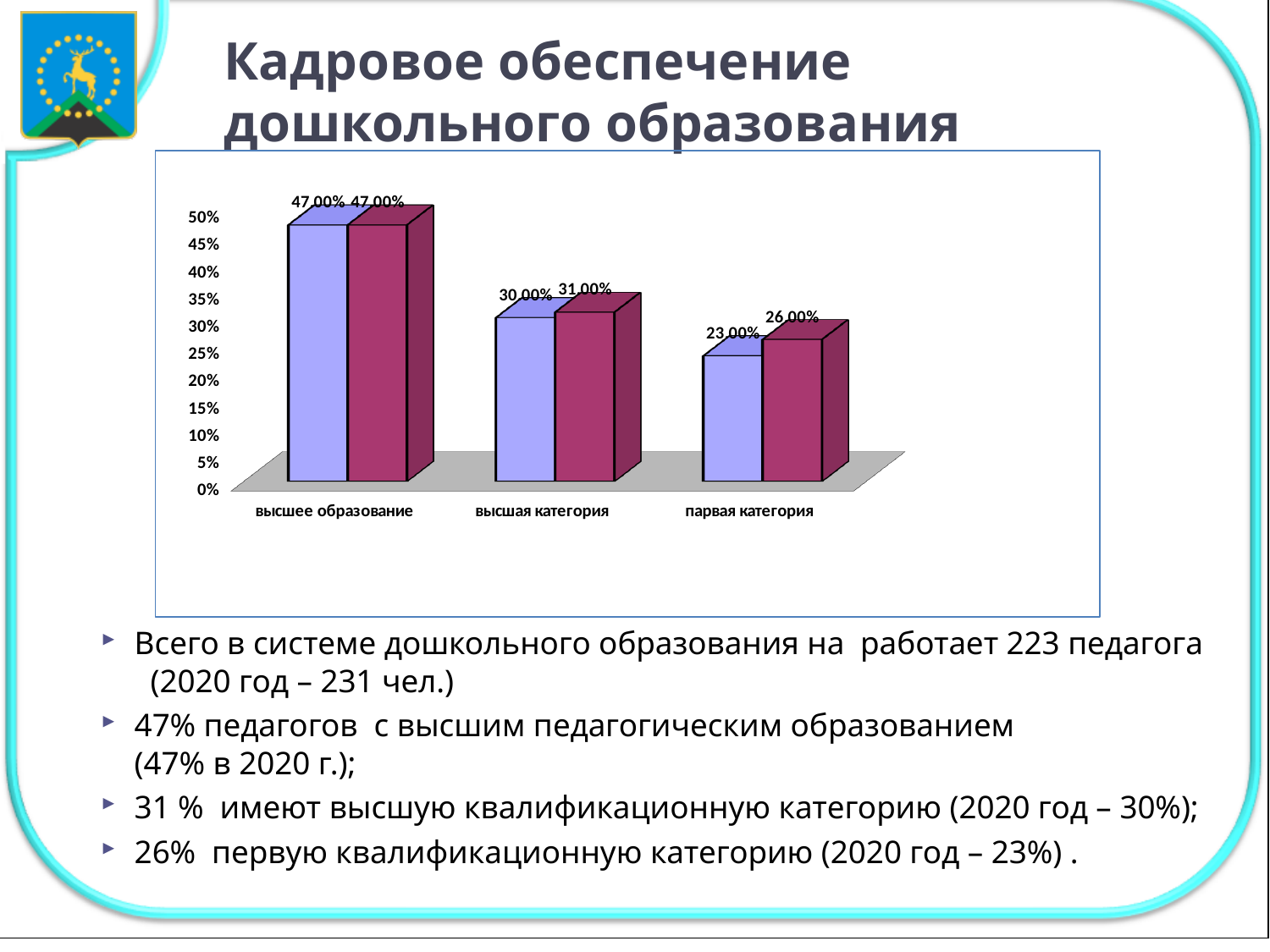
How many categories are shown on the x axis of the chart? 3 How many bars are shown for each category in the chart? 2 What is the value of the magenta bar for "высшая категория"? 31.00% Do the light blue bar values rise or fall from left to right across the categories? fall Which category has the highest values in the chart? высшее образование What is the value of the light blue bar for "парвая категория"? 23.00% For "высшая категория", which bar is larger, the light blue or the magenta one? magenta What is the value of the light blue bar for "высшее образование"? 47.00% What type of chart is shown on the slide? bar chart What is the difference between the magenta and light blue bars for "парвая категория"? 3.00% Which category has the lowest light blue bar? парвая категория What is the value of the magenta bar for "парвая категория"? 26.00%